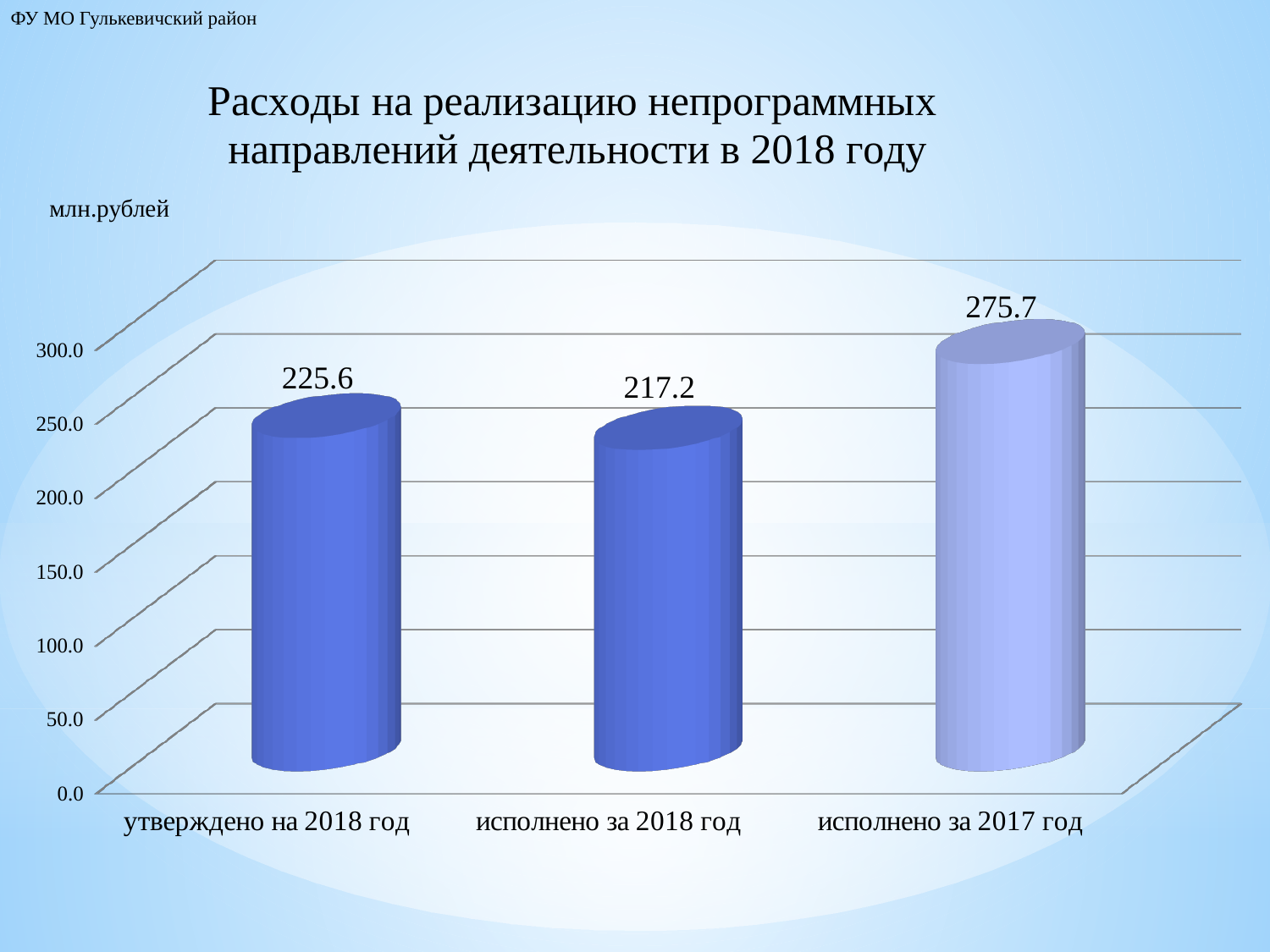
How many categories are shown on the chart? 3 Which is larger: the value for "утверждено на 2018 год" or for "исполнено за 2018 год"? утверждено на 2018 год What is the difference between the values for "утверждено на 2018 год" and "исполнено за 2018 год"? 8.4 Which category has the highest value? исполнено за 2017 год What is the value for "утверждено на 2018 год"? 225.6 What is the difference between the values for "исполнено за 2017 год" and "исполнено за 2018 год"? 58.5 What is the value for "исполнено за 2017 год"? 275.7 What unit of measurement is indicated for the chart values? млн.рублей Which category has the lowest value? исполнено за 2018 год What is the value for "исполнено за 2018 год"? 217.2 Is the value for "исполнено за 2017 год" greater or less than 250.0? greater What kind of chart is shown on the slide? bar chart